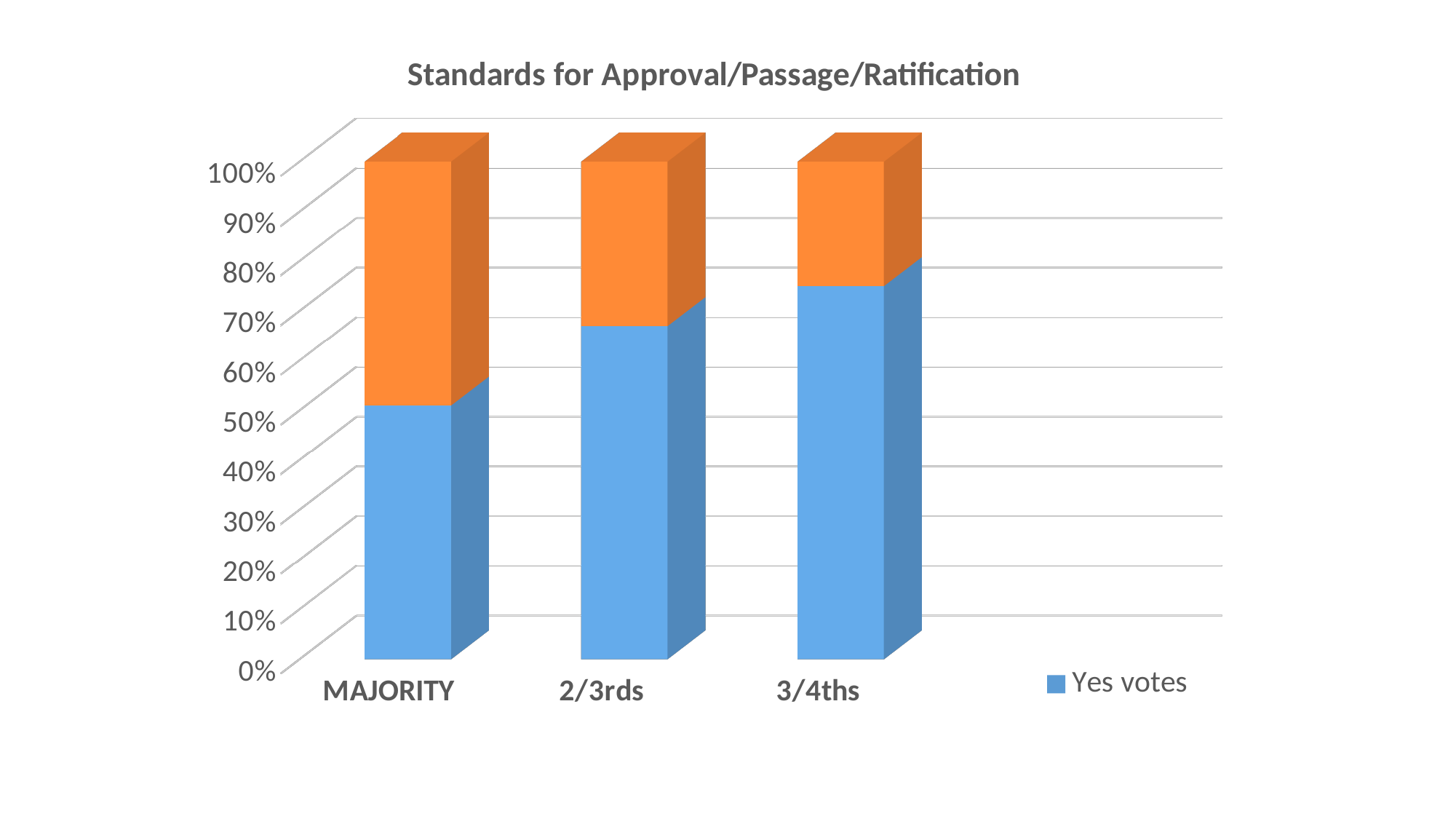
Do the Yes votes values rise or fall from MAJORITY to 3/4ths along the x axis? rise Which category has the lowest Yes votes value? MAJORITY Is the Yes votes value for 3/4ths greater or less than 70%? greater How many series does the chart's legend list? 1 Which category has the highest Yes votes value? 3/4ths Which has a larger Yes votes value, MAJORITY or 2/3rds? 2/3rds How many categories are shown on the x axis of the chart? 3 Which series is named in the chart's legend? Yes votes What kind of chart is shown on the slide? Stacked bar chart Is the Yes votes value for MAJORITY greater or less than 60%? less What is the title of the chart? Standards for Approval/Passage/Ratification Is the Yes votes value for 2/3rds greater or less than 60%? greater